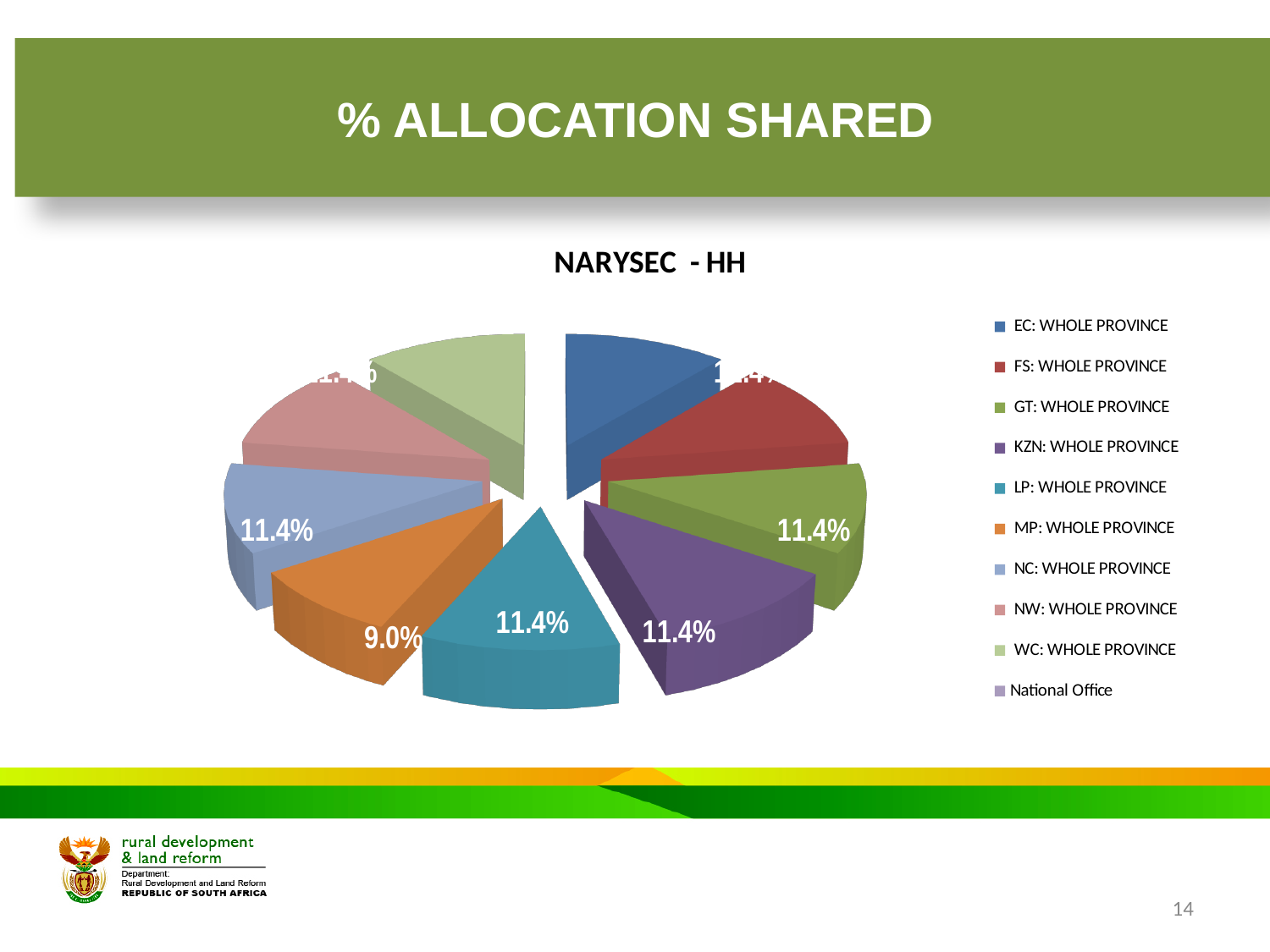
Which is larger, the share for MP: WHOLE PROVINCE or the share for LP: WHOLE PROVINCE? LP: WHOLE PROVINCE Is the share for MP: WHOLE PROVINCE greater or less than 10%? less What is the share for LP: WHOLE PROVINCE? 11.4% What is the share for NC: WHOLE PROVINCE? 11.4% What is the title of the chart? NARYSEC - HH What is the share for GT: WHOLE PROVINCE? 11.4% Which colour represents MP: WHOLE PROVINCE in the legend? orange How many entries does the chart legend list? 10 What type of chart is shown on the slide? pie chart What is the share for KZN: WHOLE PROVINCE? 11.4% What is the difference between the share for NC: WHOLE PROVINCE and the share for MP: WHOLE PROVINCE? 2.4% What is the share for MP: WHOLE PROVINCE? 9.0%